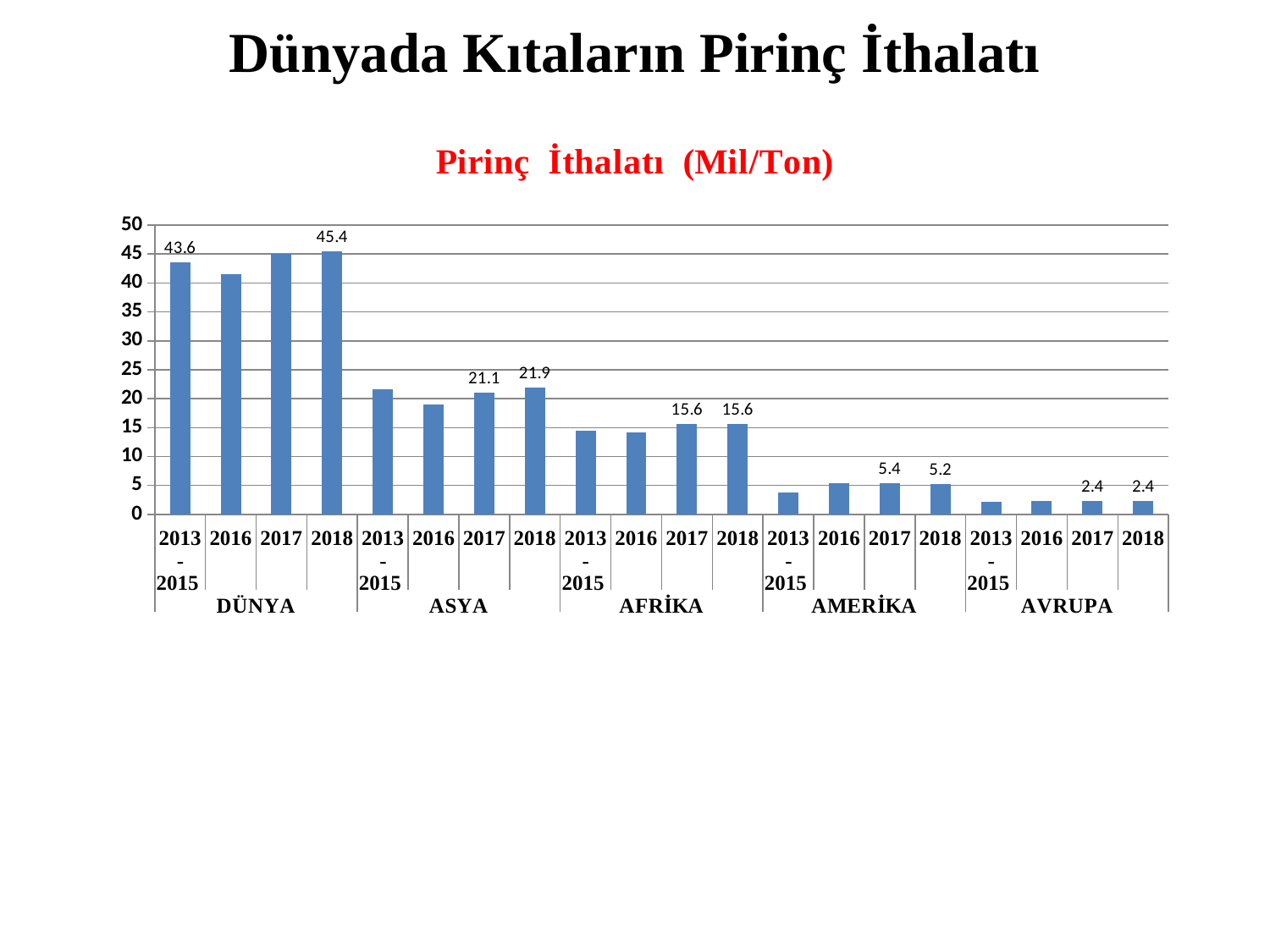
What is the value for AMERİKA in 2017? 5.4 What is the difference between the DÜNYA values for 2018 and 2013-2015? 1.8 How many region groups are shown along the x axis? 5 What type of chart is shown on the slide? Bar chart What is the value for ASYA in 2017? 21.1 What is the difference between the ASYA values for 2018 and 2017? 0.8 For AMERİKA, which year has the larger value, 2017 or 2018? 2017 Is the value for ASYA in 2016 greater or less than 20? less Which bar has the highest value in the chart? DÜNYA 2018 What is the value for DÜNYA in 2018? 45.4 What is the value for AFRİKA in 2018? 15.6 Is the value for DÜNYA in 2016 greater or less than 40? greater